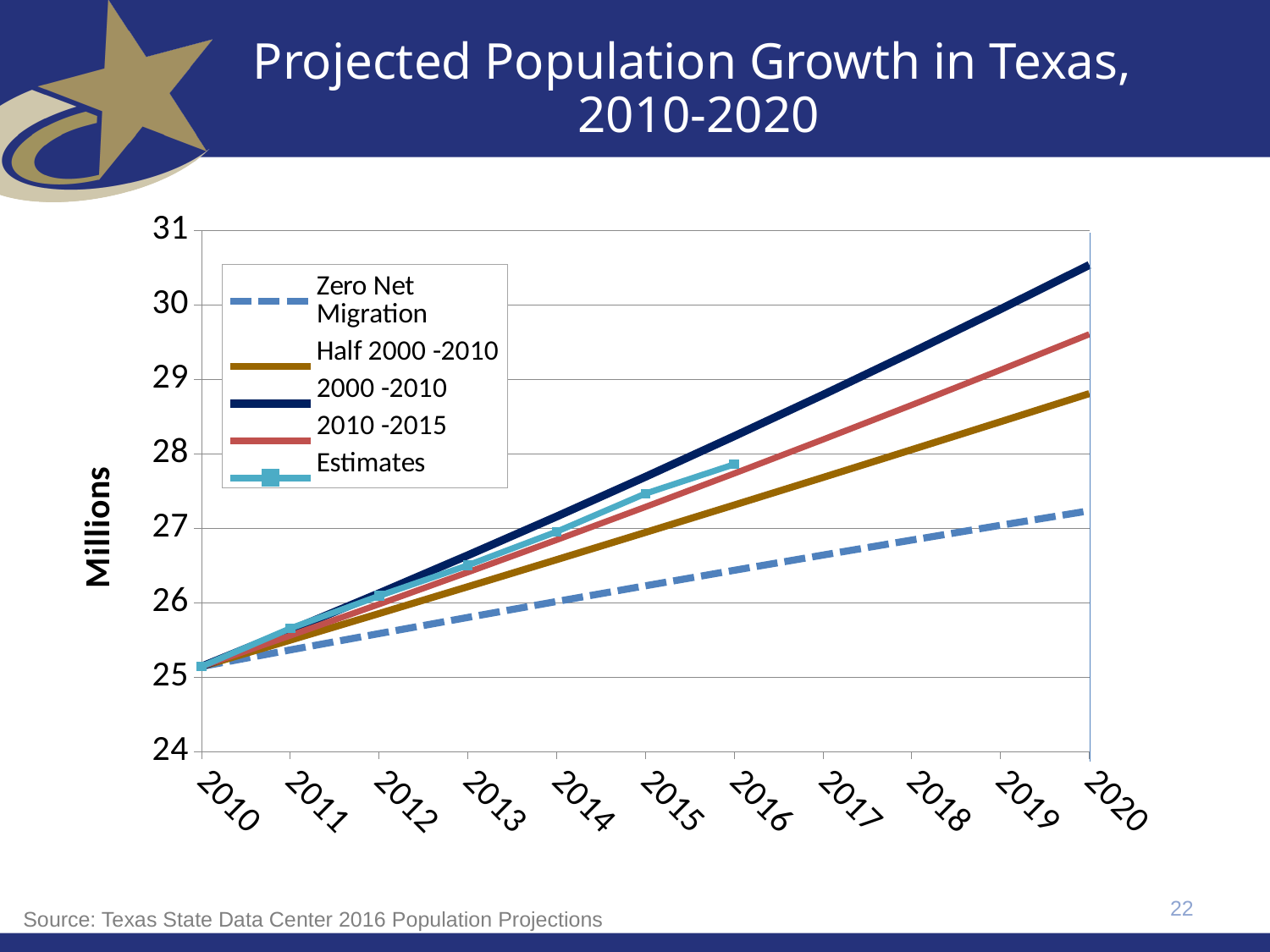
Which series has the lowest value in 2020? Zero Net Migration Is the value for the 2000 -2010 series in 2020 greater or less than 30? greater Is the value for the 2010 -2015 series in 2020 greater or less than 29? greater Which series has the highest value in 2020? 2000 -2010 How many years are labelled along the x axis? 11 Do the values of the Zero Net Migration series rise or fall from 2010 to 2020? rise How many series does the legend list? 5 In 2020, which is larger: the 2010 -2015 series or the Half 2000 -2010 series? 2010 -2015 What kind of chart is shown on the slide? line chart What is the label on the y axis? Millions Is the value for the Zero Net Migration series in 2020 greater or less than 28? less